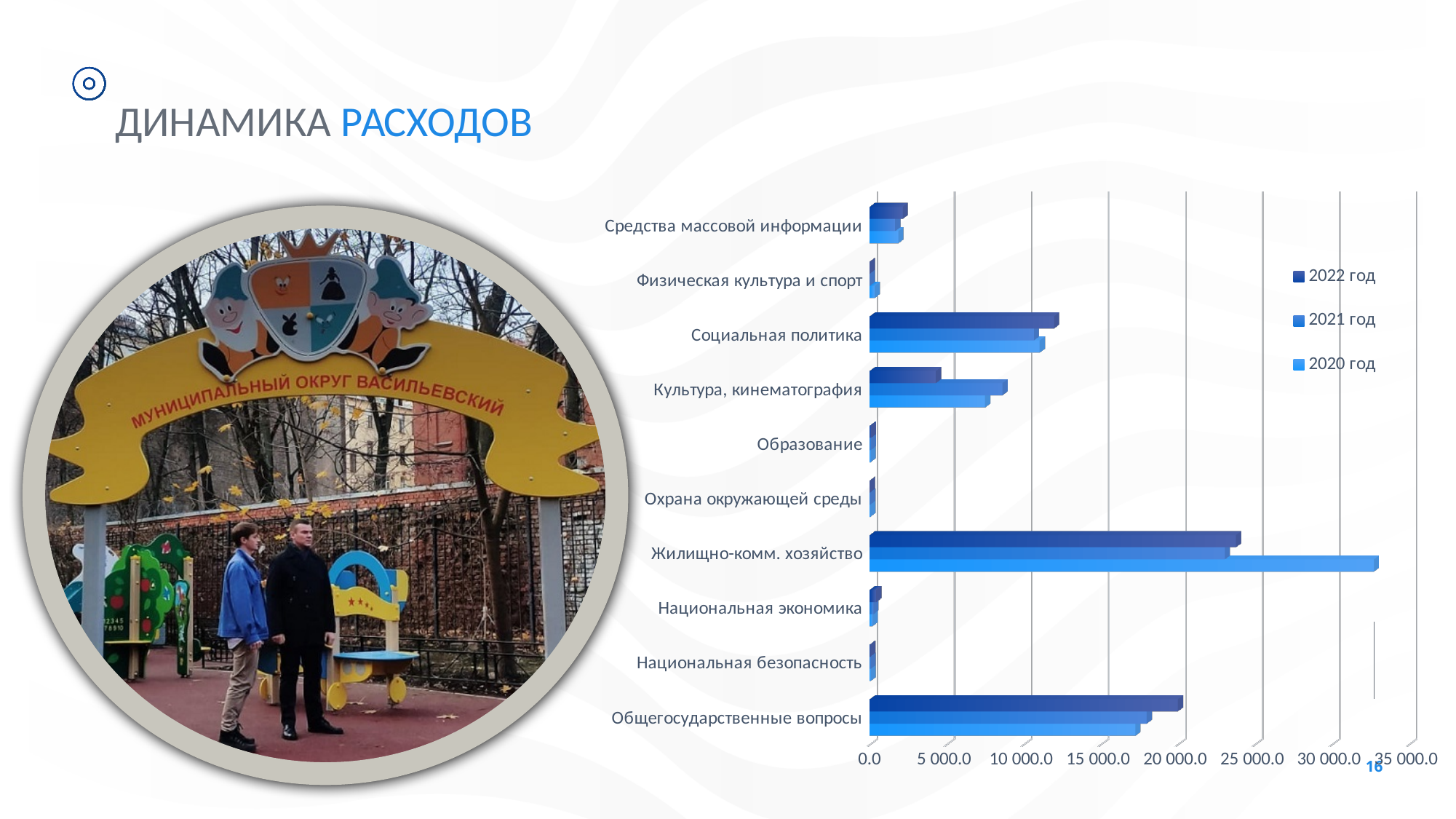
Is the 2022 год value for Социальная политика greater or less than 10 000.0? greater How many expenditure categories are listed on the chart? 10 Is the 2020 год value for Жилищно-комм. хозяйство greater or less than 30 000.0? greater Which category has the longest bar on the chart? Жилищно-комм. хозяйство How many series does the chart legend list? 3 Which category has the highest value for the 2022 год series? Жилищно-комм. хозяйство Which years are listed in the chart legend? 2022 год, 2021 год, 2020 год What kind of chart is shown on the slide? bar chart For Культура, кинематография, which is larger: the 2022 год value or the 2021 год value? 2021 год What is the title of the slide containing the chart? ДИНАМИКА РАСХОДОВ For Жилищно-комм. хозяйство, which is larger: the 2020 год value or the 2022 год value? 2020 год Is the 2022 год value for Культура, кинематография greater or less than 5 000.0? less